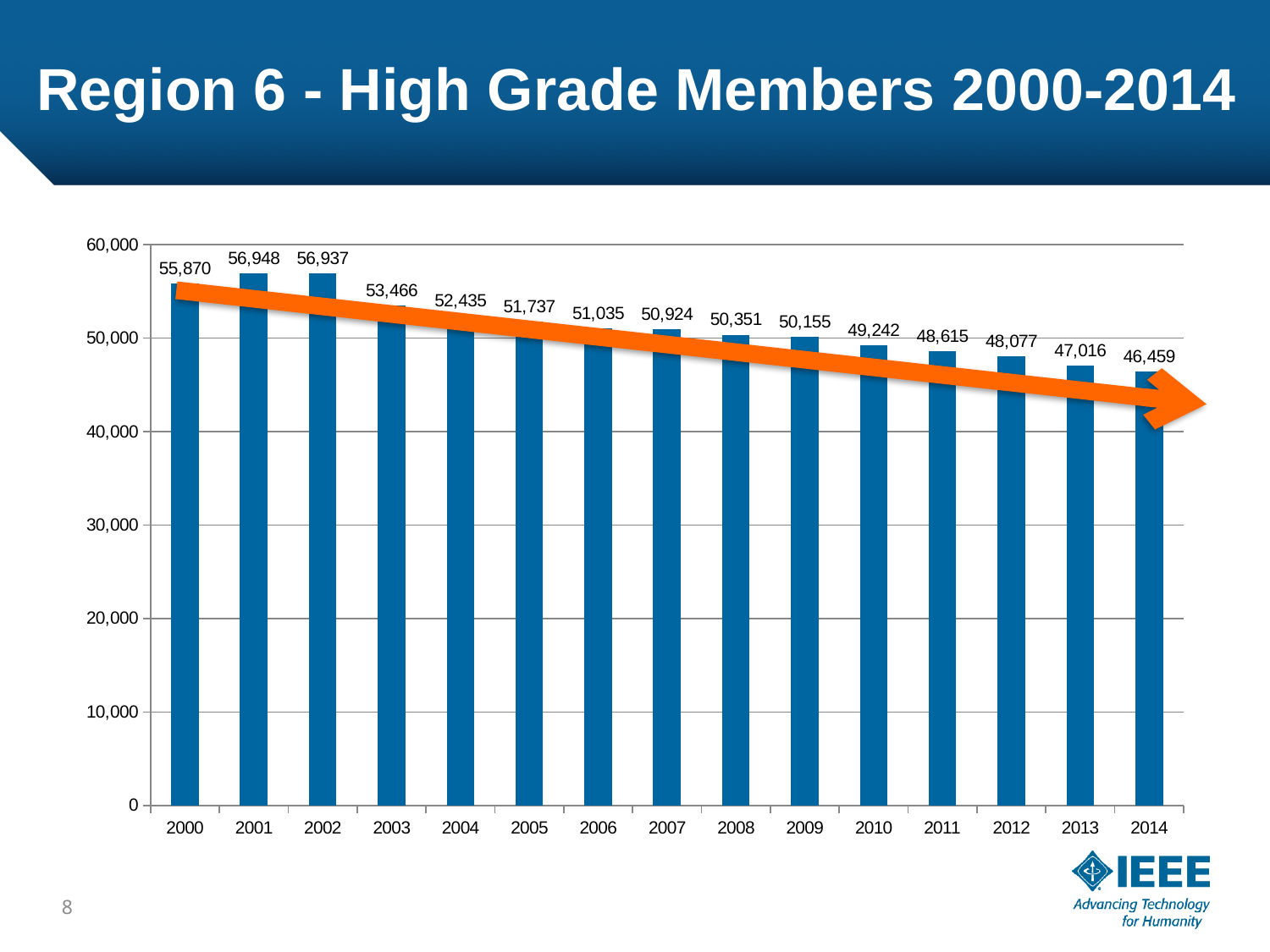
Do the values generally rise or fall from 2002 to 2014? fall What is the difference between the values for 2000 and 2014? 9,411 Which is larger, the value for 2005 or the value for 2009? 2005 What is the difference between the values for 2002 and 2003? 3,471 Which year has the lowest value? 2014 Which year has the highest value? 2001 How many years are shown on the x axis? 15 Is the value for 2010 greater or less than 50,000? less What is the value for 2000? 55,870 What is the value for 2014? 46,459 What kind of chart is shown on the slide? bar chart What is the value for 2007? 50,924